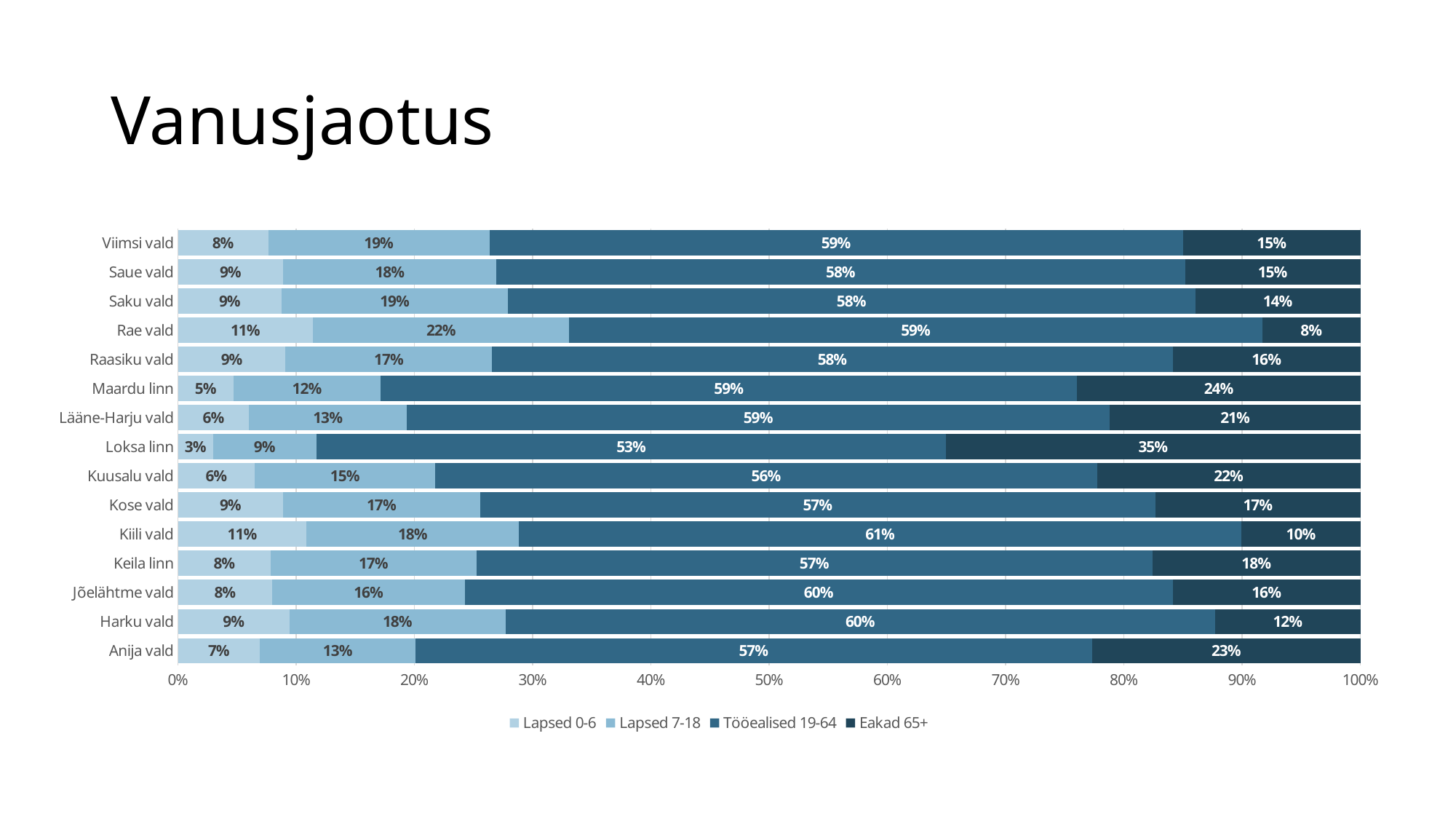
What is the value for Eakad 65+ in Loksa linn? 35% Which is larger: the Tööealised 19-64 share in Kiili vald or in Loksa linn? Kiili vald What is the value for Lapsed 0-6 in Maardu linn? 5% Which municipality has the lowest share of Lapsed 0-6? Loksa linn Which municipality has the lowest share of Eakad 65+? Rae vald What kind of chart is shown on the slide? Stacked bar chart What is the value for Lapsed 7-18 in Rae vald? 22% What is the difference between the Eakad 65+ share in Loksa linn and in Rae vald? 27 percentage points Which municipality has the highest share of Eakad 65+? Loksa linn What is the value for Tööealised 19-64 in Kiili vald? 61% How many series does the legend list? 4 How many municipalities are shown in the chart? 15